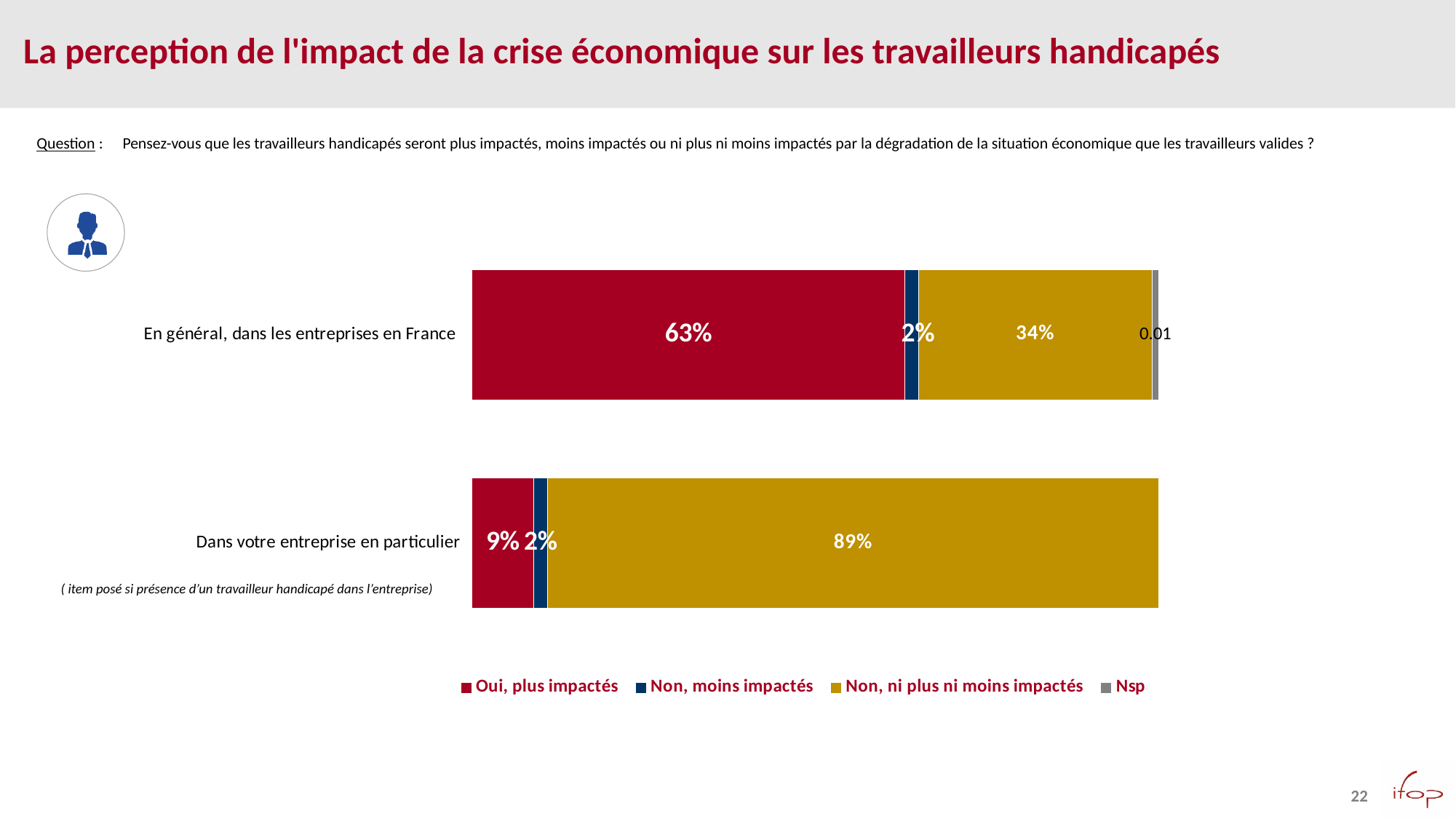
Which legend entry is shown in grey? Nsp What is the value for "Non, moins impactés" for "Dans votre entreprise en particulier"? 2% Which category has the higher value for "Oui, plus impactés": "En général, dans les entreprises en France" or "Dans votre entreprise en particulier"? En général, dans les entreprises en France What is the value for "Oui, plus impactés" for "Dans votre entreprise en particulier"? 9% How many categories (bars) are plotted in the chart? 2 What is the difference between the "Oui, plus impactés" values for "En général, dans les entreprises en France" and "Dans votre entreprise en particulier"? 54 percentage points What is the difference between the "Non, ni plus ni moins impactés" values for "Dans votre entreprise en particulier" and "En général, dans les entreprises en France"? 55 percentage points What is the value for "Oui, plus impactés" for "En général, dans les entreprises en France"? 63% What is the value for "Non, ni plus ni moins impactés" for "En général, dans les entreprises en France"? 34% What kind of chart is shown on the slide? stacked bar chart How many series does the legend list? 4 What is the value for "Non, ni plus ni moins impactés" for "Dans votre entreprise en particulier"? 89%